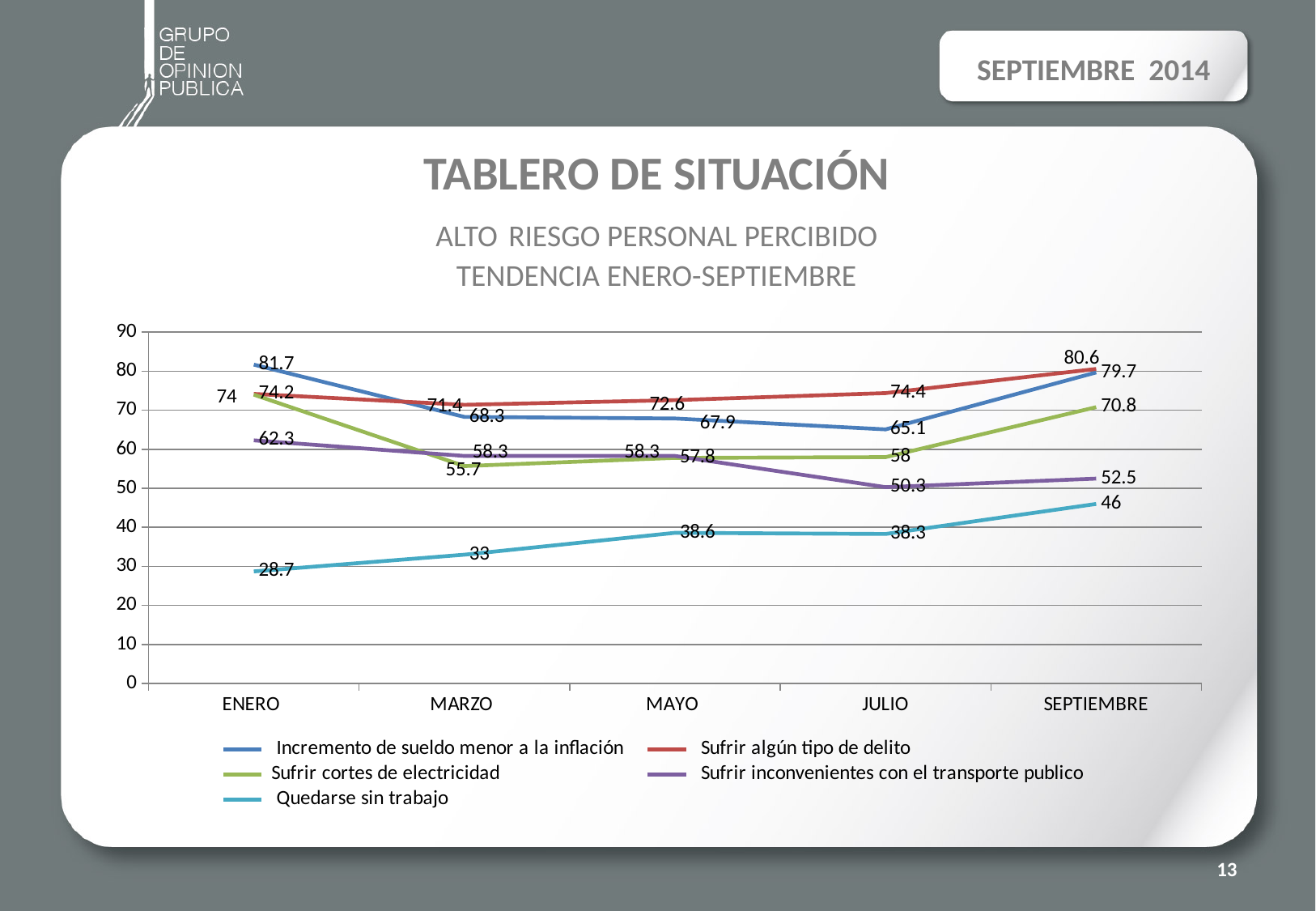
How many months are shown along the x axis? 5 What is the value for Sufrir algún tipo de delito in SEPTIEMBRE? 80.6 What is the value for Sufrir inconvenientes con el transporte publico in JULIO? 50.3 What kind of chart is shown on the slide? line chart What is the value for Quedarse sin trabajo in SEPTIEMBRE? 46 What is the value for Incremento de sueldo menor a la inflación in ENERO? 81.7 Does the Quedarse sin trabajo line rise or fall overall from ENERO to SEPTIEMBRE? rise How many series does the legend list? 5 In which month is Quedarse sin trabajo highest? SEPTIEMBRE In which month is Incremento de sueldo menor a la inflación lowest? JULIO By how much did Quedarse sin trabajo increase from ENERO to SEPTIEMBRE? 17.3 In JULIO, which is larger: Sufrir algún tipo de delito or Incremento de sueldo menor a la inflación? Sufrir algún tipo de delito